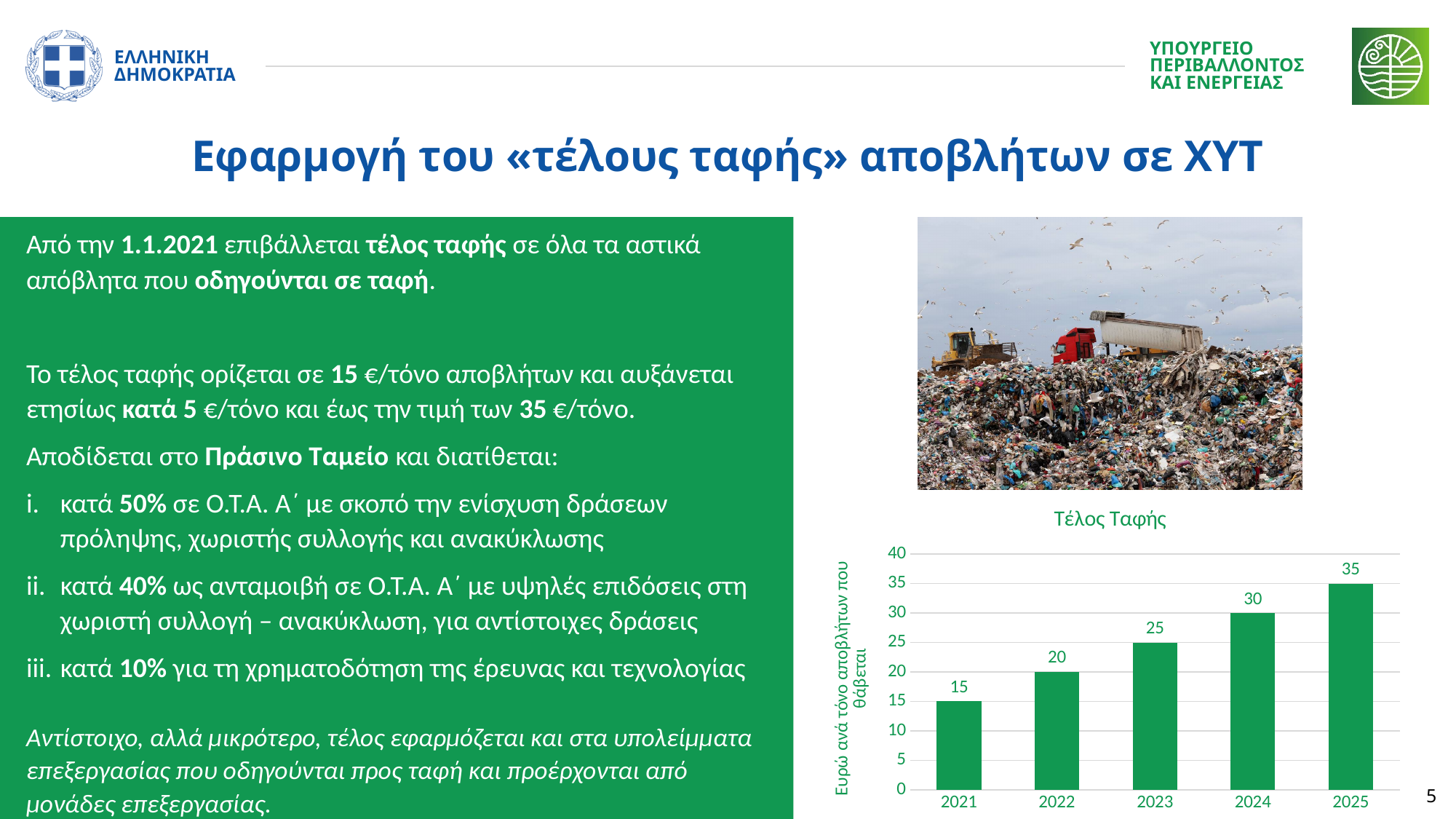
What is the title of the chart? Τέλος Ταφής What kind of chart is shown on the slide? bar chart What is the label of the y axis of the chart? Ευρώ ανά τόνο αποβλήτων που θάβεται What is the value for 2023 in the chart? 25 Which year has the lowest value in the chart? 2021 How many years are shown on the x axis of the chart? 5 Do the values rise or fall from 2021 to 2025? rise Which year has the highest value in the chart? 2025 What is the value for 2021 in the chart? 15 Which is larger, the value for 2022 or the value for 2024? 2024 What is the difference between the values for 2024 and 2022? 10 What is the value for 2025 in the chart? 35